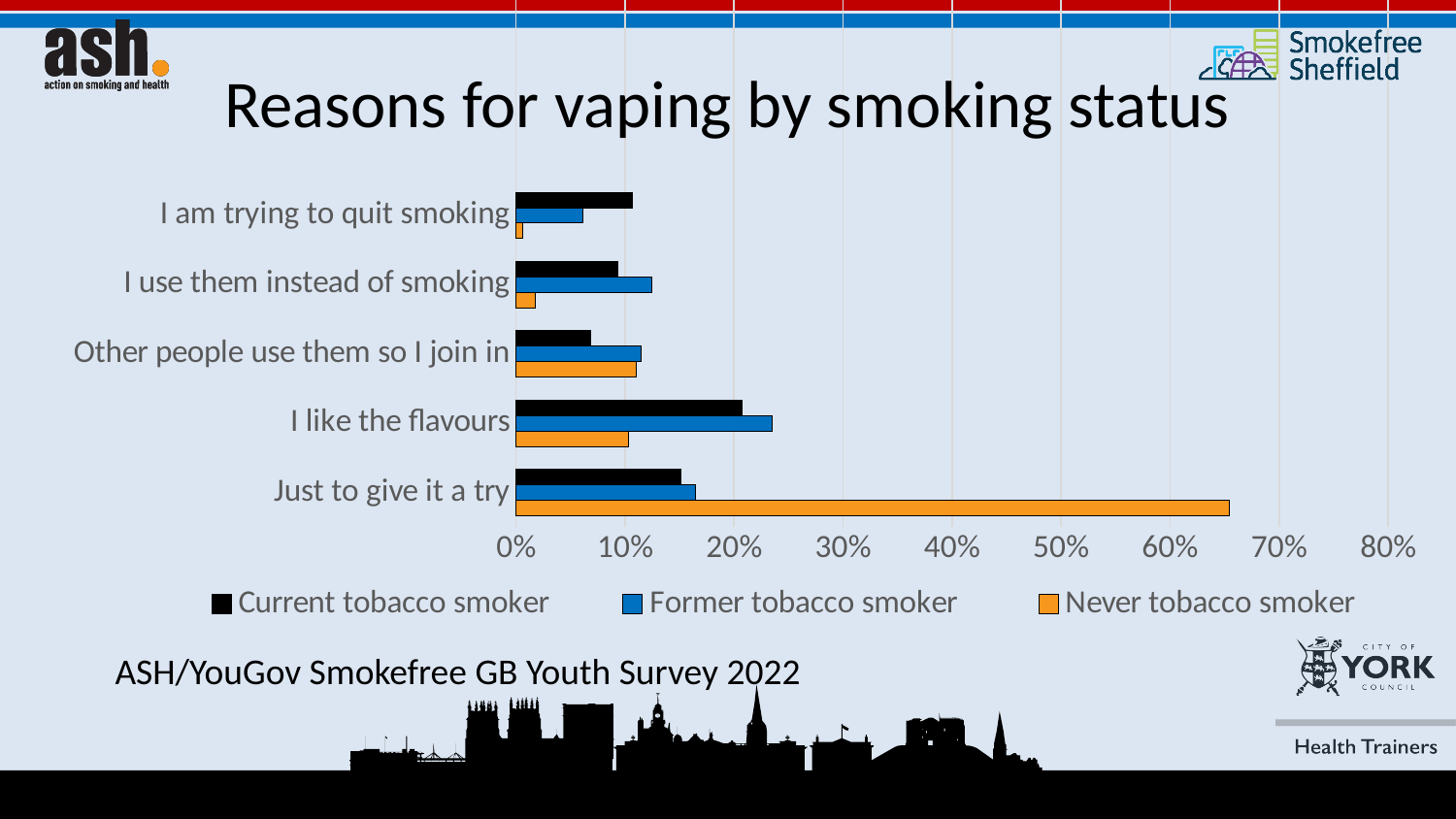
For which reason is the Never tobacco smoker bar the shortest? I am trying to quit smoking What kind of chart is shown on the slide? Bar chart Is the Current tobacco smoker value for 'I like the flavours' greater or less than 30%? less Is the Never tobacco smoker value for 'Just to give it a try' greater or less than 60%? greater For 'I use them instead of smoking', which is larger: the Former tobacco smoker value or the Current tobacco smoker value? Former tobacco smoker For 'I am trying to quit smoking', which is larger: the Current tobacco smoker value or the Never tobacco smoker value? Current tobacco smoker How many reasons for vaping are listed on the chart? 5 Is the Former tobacco smoker value for 'I like the flavours' greater or less than 20%? greater For which reason is the Current tobacco smoker bar the longest? I like the flavours How many series does the legend list? 3 For which reason is the Never tobacco smoker bar the longest? Just to give it a try What colour represents Never tobacco smoker in the legend? Orange